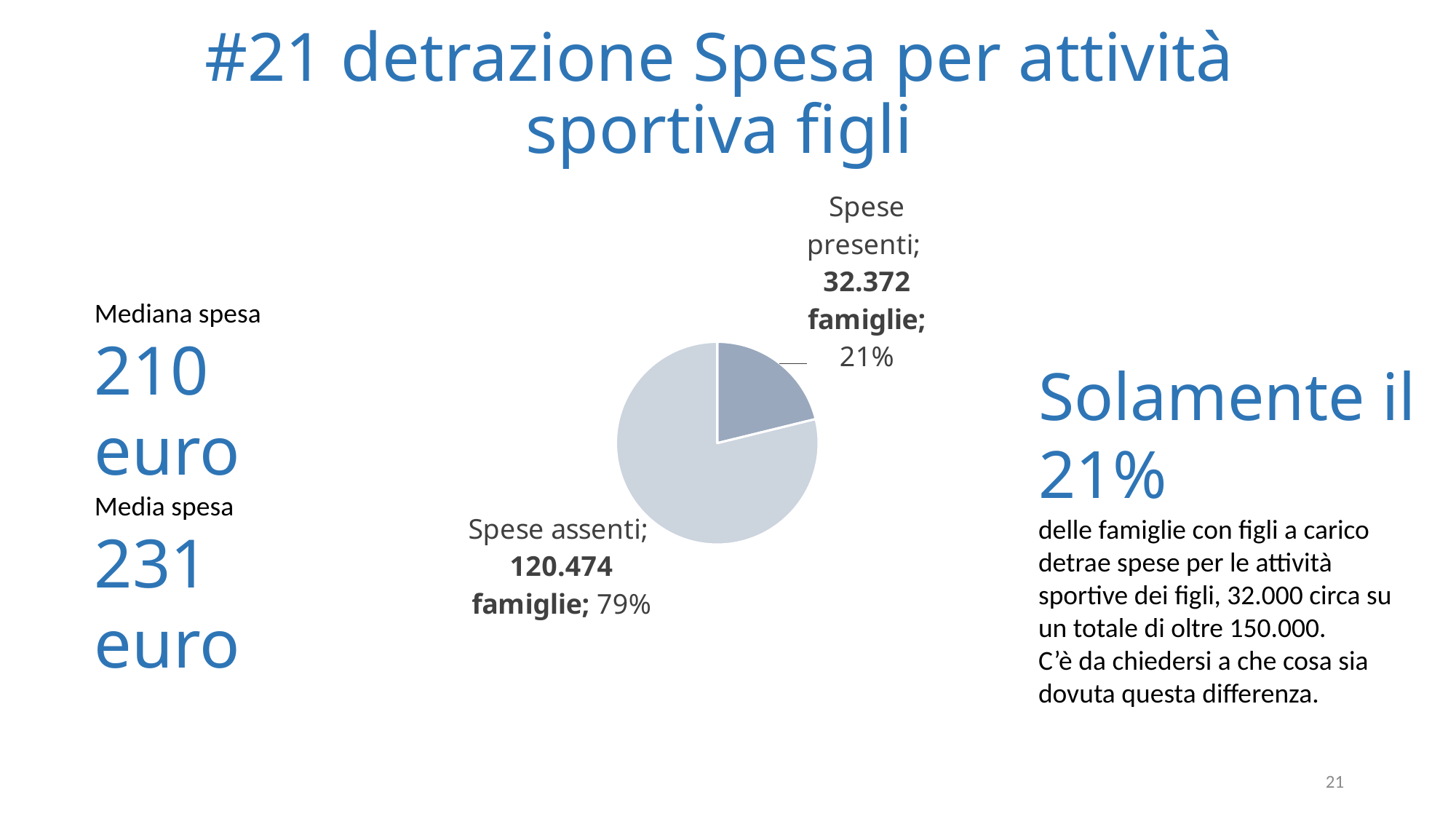
Which slice of the pie chart is the smallest? Spese presenti Which slice of the pie chart is the largest? Spese assenti Which slice of the pie chart is drawn in the darker blue-grey colour? Spese presenti How many families are in the 'Spese presenti' slice of the pie chart? 32.372 famiglie How many slices does the pie chart have? 2 What share of the pie does 'Spese presenti' represent? 21% What is the difference in number of families between 'Spese assenti' and 'Spese presenti' in the pie chart? 88.102 What is the total number of families across both slices of the pie chart? 152.846 What kind of chart is shown on the slide? pie chart Which is larger in the pie chart, 'Spese presenti' or 'Spese assenti'? Spese assenti How many families are in the 'Spese assenti' slice of the pie chart? 120.474 famiglie What share of the pie does 'Spese assenti' represent? 79%